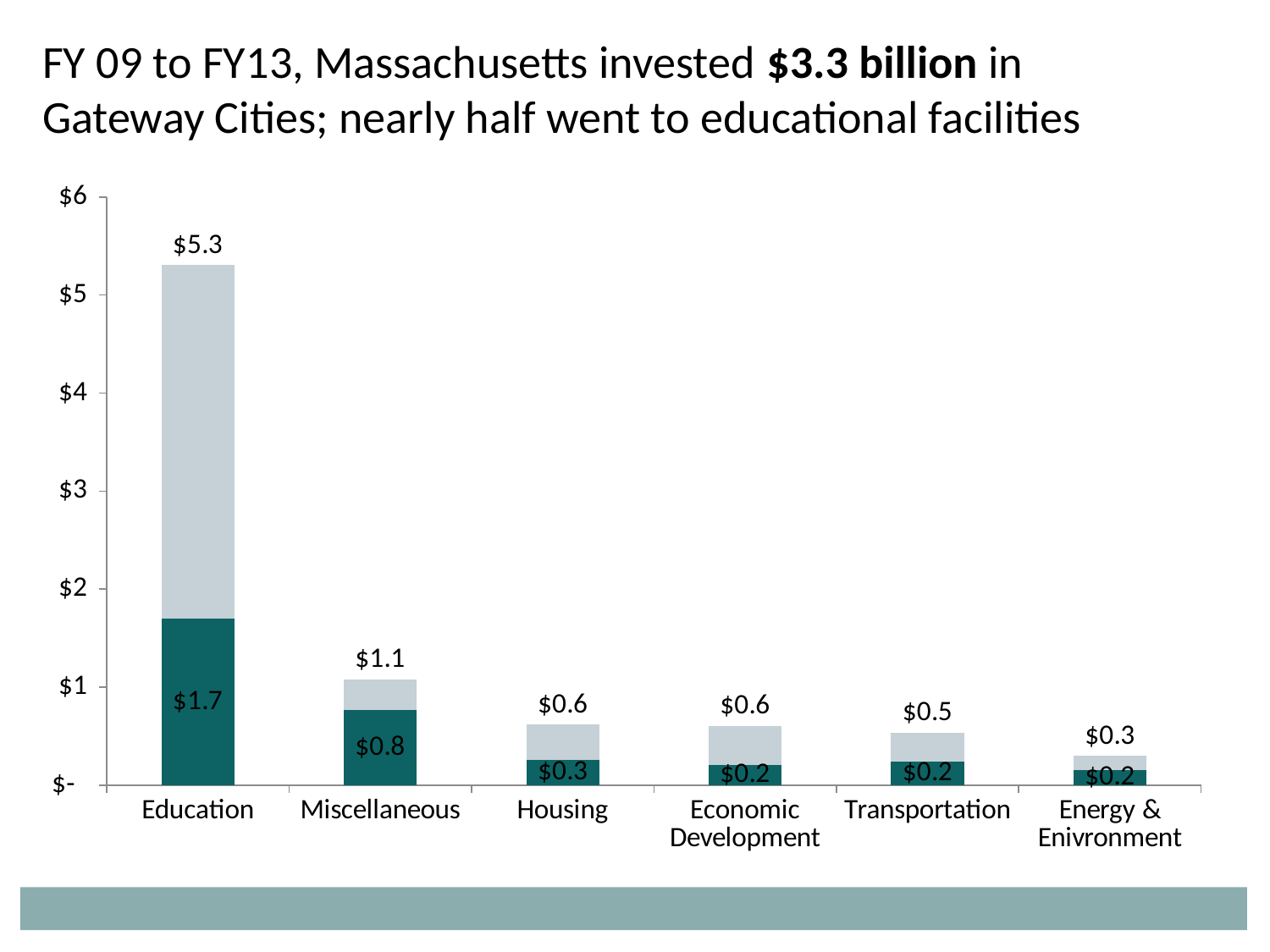
What is the value of the dark teal segment for Miscellaneous? $0.8 Which is larger, the total for Miscellaneous or the total for Housing? Miscellaneous Which category has the lowest total bar? Energy & Enivronment What is the value of the dark teal segment for Housing? $0.3 What is the total value labeled above the Transportation bar? $0.5 What is the total value labeled above the Education bar? $5.3 Do the total bar values generally rise or fall moving from left to right along the x axis? fall Is the total value for Education greater or less than $5? greater Which category has the highest total bar? Education How many categories are shown on the x axis of the chart? 6 What is the difference between the total for Education ($5.3) and the total for Miscellaneous ($1.1)? $4.2 What kind of chart is shown on the slide? stacked bar chart